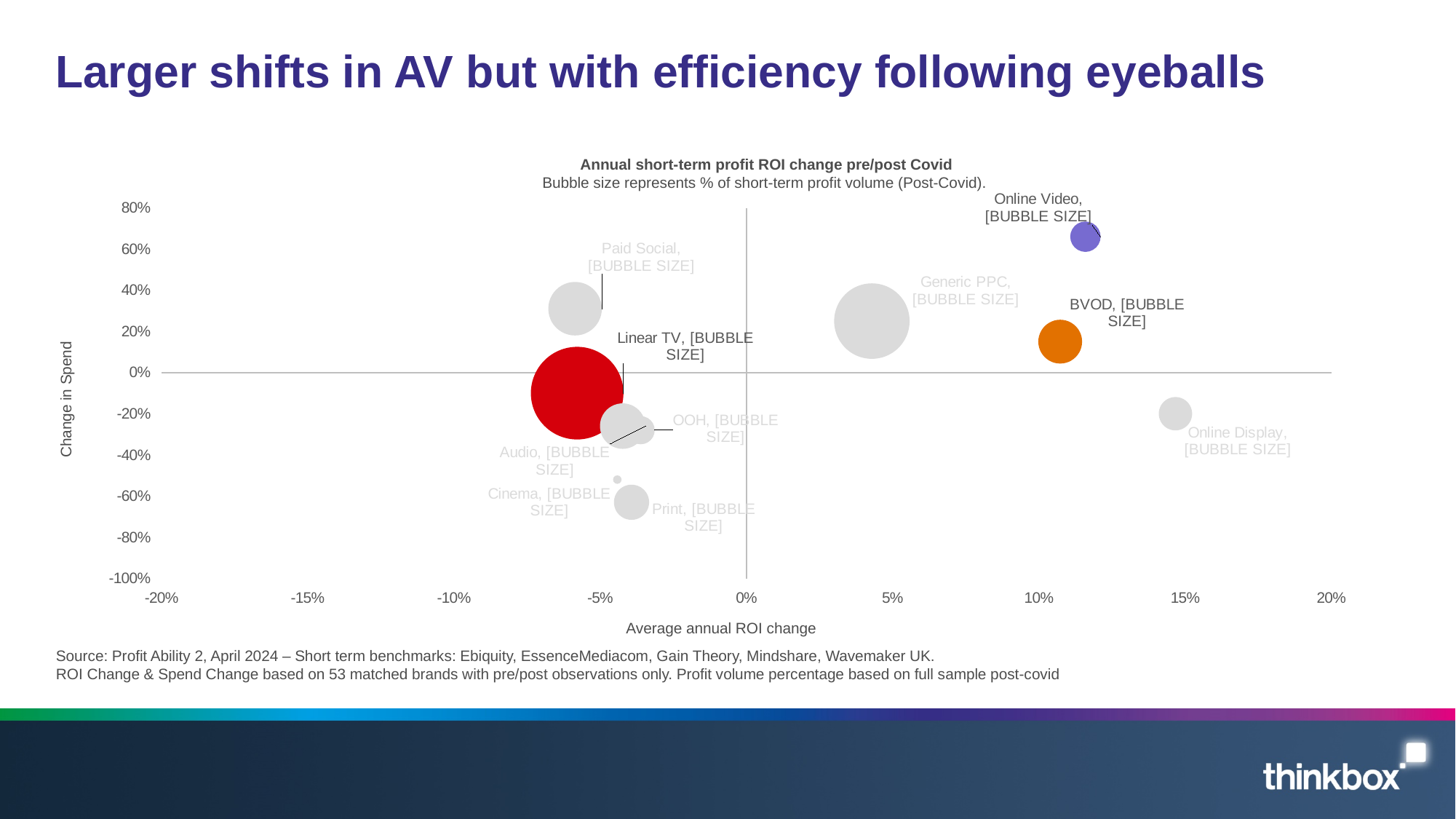
What kind of chart is shown on the slide? Bubble chart Which has the larger change in spend, Online Video or Online Display? Online Video Which has the larger average annual ROI change, BVOD or Linear TV? BVOD What is the title of the chart? Annual short-term profit ROI change pre/post Covid What does the x axis of the chart represent? Average annual ROI change Is the change in spend for Online Video greater or less than 40%? greater Which category has the highest change in spend? Online Video Which category has the highest average annual ROI change? Online Display Is the average annual ROI change for Online Display greater or less than 10%? greater How many labelled media categories are plotted on the chart? 10 Is the change in spend for Paid Social greater or less than 20%? greater